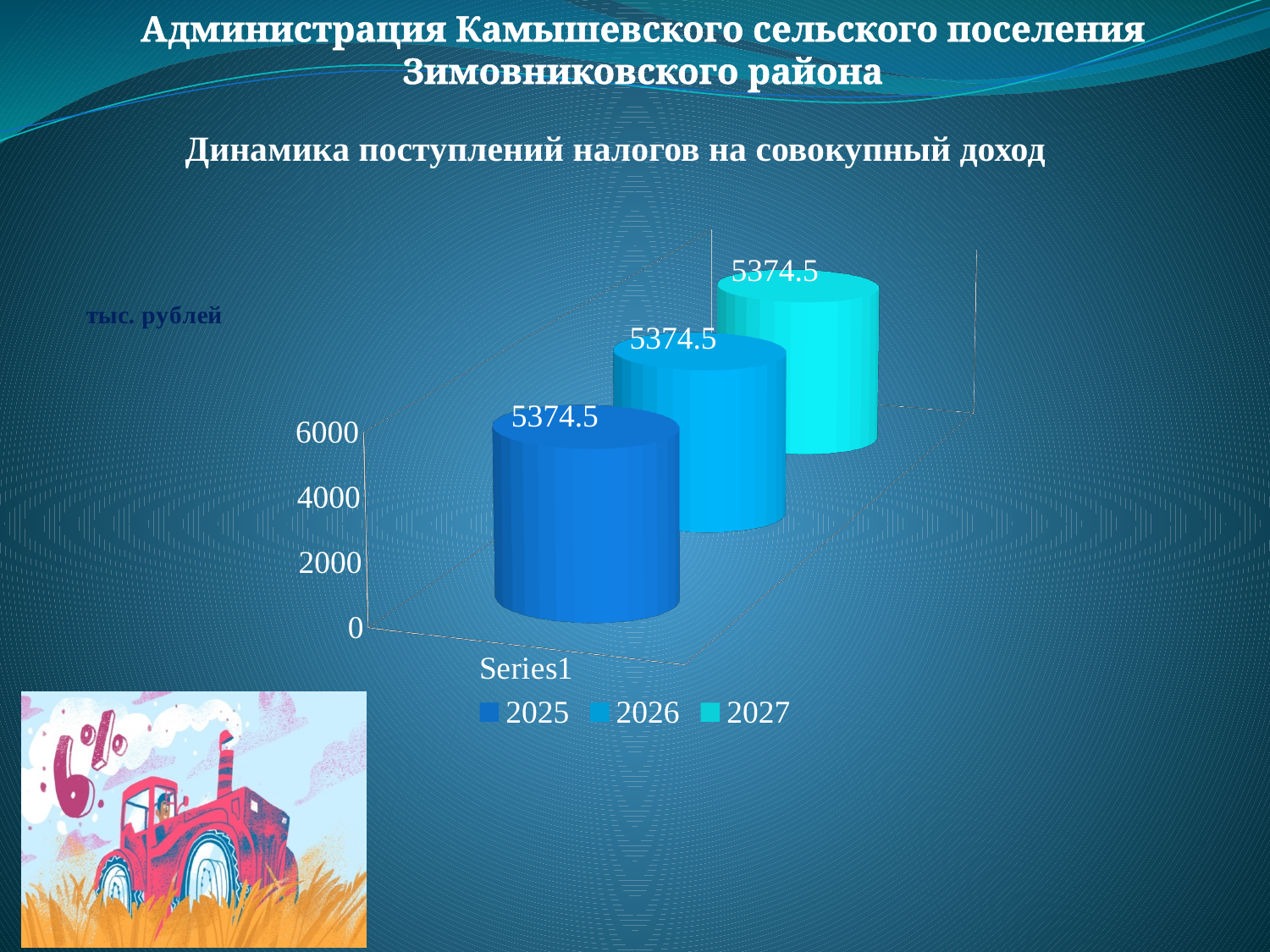
What is the difference between the values for 2027 and 2025? 0 How many series does the legend list? 3 What is the value for 2027 in the chart? 5374.5 What is the value for 2025 in the chart? 5374.5 What kind of chart is shown on the slide? Bar chart In what units are the chart values given? тыс. рублей Is the value for 2027 greater or less than 6000? less What is the value for 2026 in the chart? 5374.5 What is the label on the category axis of the chart? Series1 Is the value for 2025 greater or less than 4000? greater Do the values rise, fall, or stay the same from 2025 to 2027? Stay the same What is the title of the chart? Динамика поступлений налогов на совокупный доход